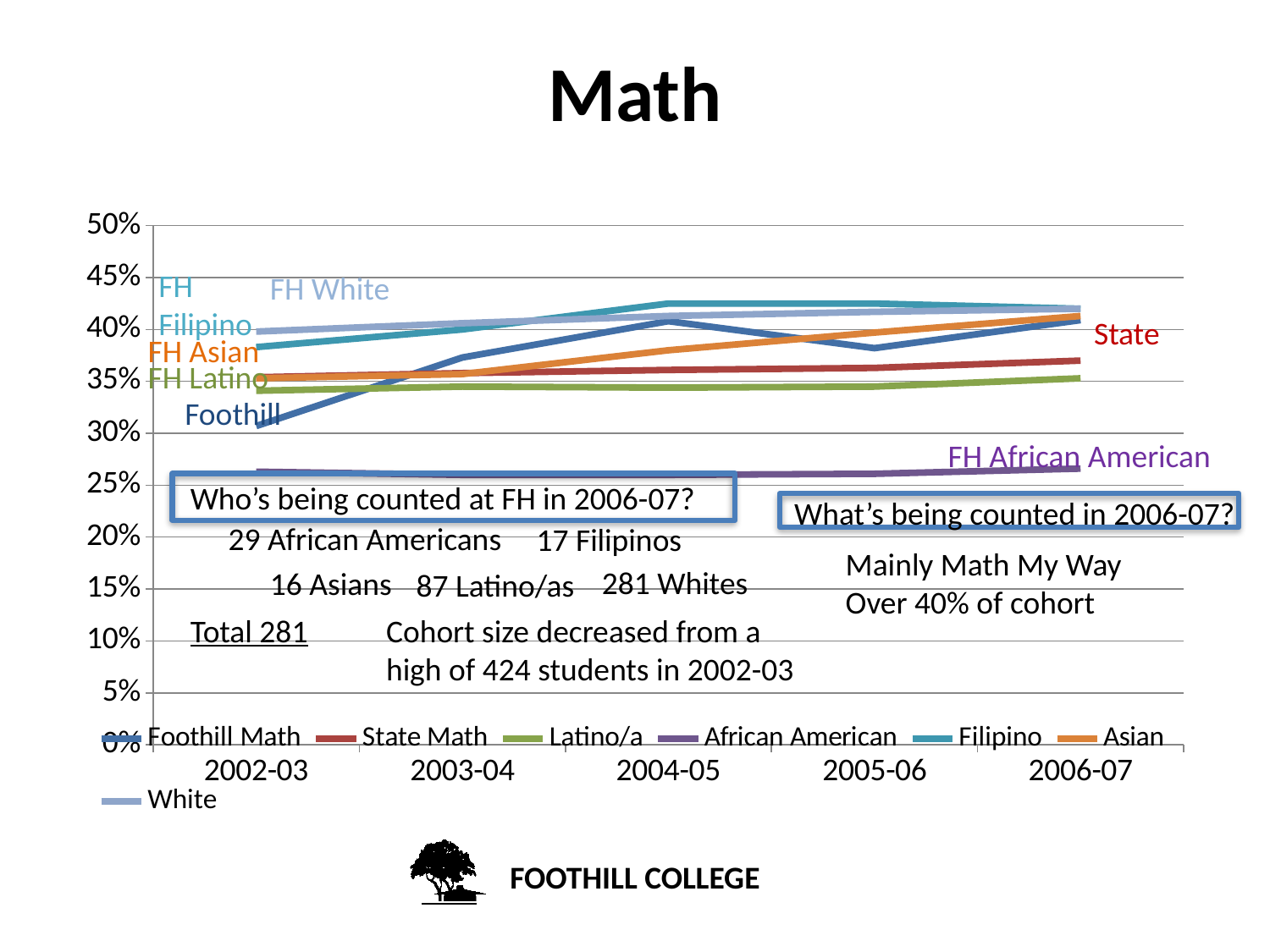
Which is larger in 2006-07, Foothill Math or State Math? Foothill Math Is the value for African American in 2006-07 greater or less than 30%? less Is the value for State Math in 2006-07 greater or less than 40%? less Which series has the lowest value in 2006-07? African American Which series has the lowest value in 2002-03? African American Is the value for Filipino in 2006-07 greater or less than 40%? greater Which is larger in 2002-03, Foothill Math or State Math? State Math How many academic years are shown on the x axis? 5 How many series does the legend list? 7 What kind of chart is shown on the slide? line chart Does the Foothill Math line rise or fall from 2002-03 to 2004-05? rise What is the title of the chart? Math